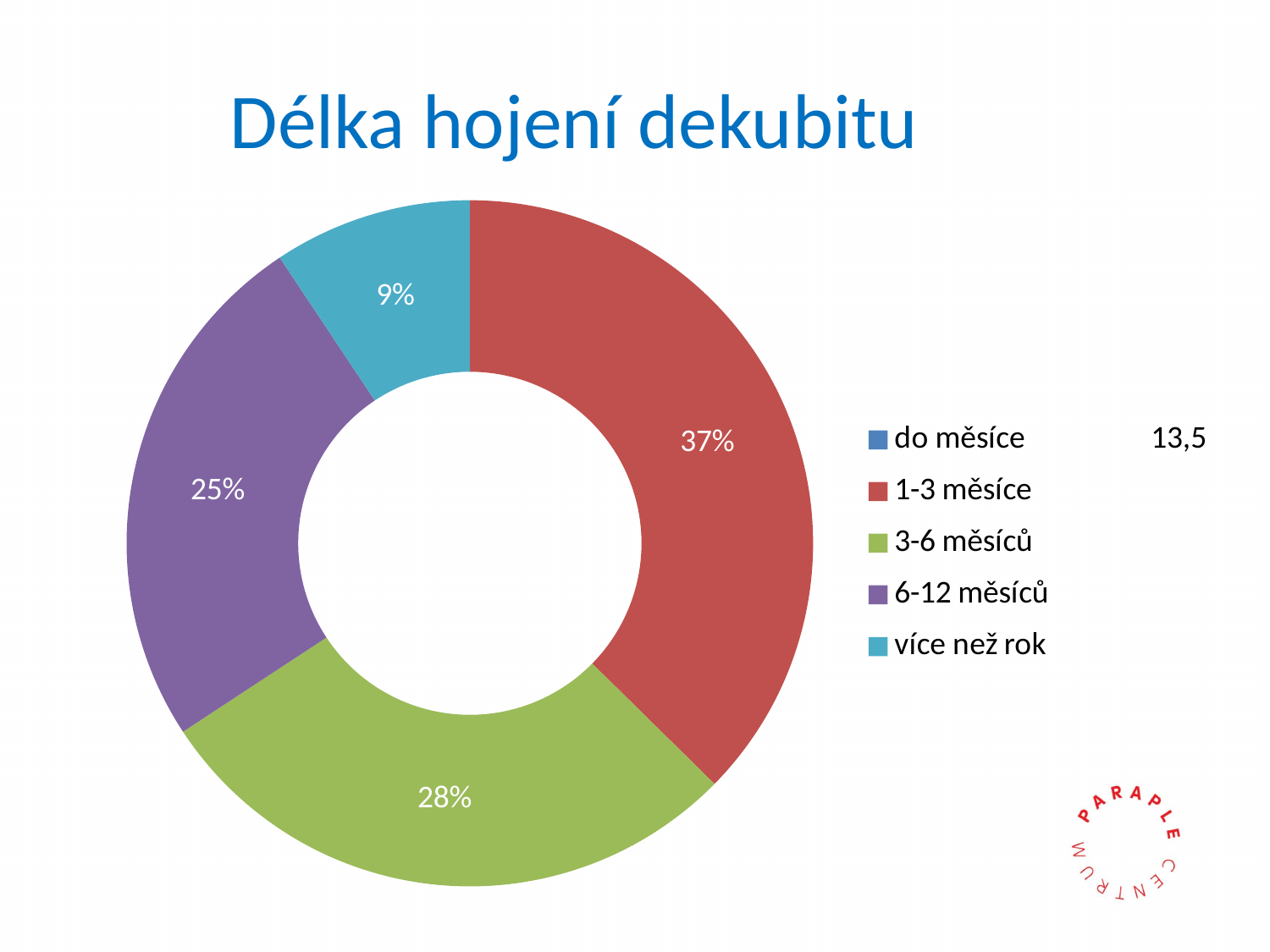
Which category has the largest share of the chart? 1-3 měsíce What percentage is shown for the 3-6 měsíců slice? 28% Which is larger, the share for 6-12 měsíců or the share for více než rok? 6-12 měsíců What is the difference between the 3-6 měsíců share and the 6-12 měsíců share? 3 percentage points What percentage is shown for the 6-12 měsíců slice? 25% What kind of chart is shown on the slide? Doughnut (pie) chart How many percentage points larger is the 1-3 měsíce share than the 3-6 měsíců share? 9 percentage points Which of the labelled slices has the smallest share? více než rok How many entries does the legend list? 5 What percentage is shown for the 1-3 měsíce slice? 37% What percentage is shown for the více než rok slice? 9% What is the title of the chart? Délka hojení dekubitu